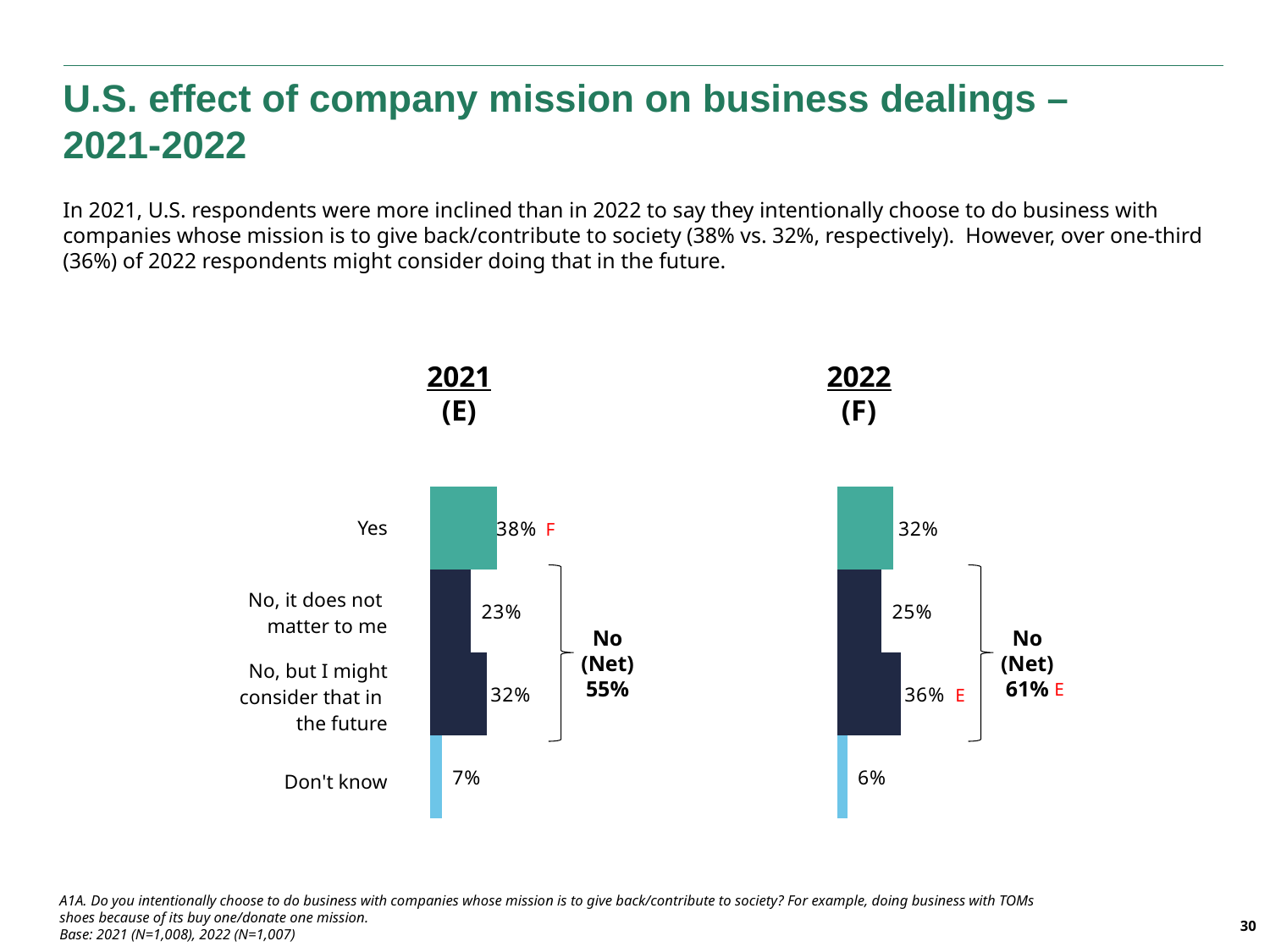
Which is larger: the "No, it does not matter to me" value in the 2021 (E) chart or in the 2022 (F) chart? 2022 (F) In the 2022 (F) chart, what percentage of respondents answered "No, but I might consider that in the future"? 36% In the 2021 (E) chart, which response category has the highest percentage? Yes What colour is the bar for the "Yes" category in both charts? Teal/green What type of chart is used to show the 2022 (F) results? Bar chart In the 2022 (F) chart, what is the difference between the "No (Net)" value and the "Yes" value? 29 percentage points How many response categories are shown in the 2021 (E) chart? 4 In the 2021 (E) chart, what is the "No (Net)" value? 55% In the 2021 (E) chart, what percentage of respondents answered "Yes"? 38% In the 2022 (F) chart, what percentage of respondents answered "Don't know"? 6% What is the difference between the "Yes" percentage in the 2021 (E) chart and the "Yes" percentage in the 2022 (F) chart? 6 percentage points In the 2022 (F) chart, which response category has the lowest percentage? Don't know